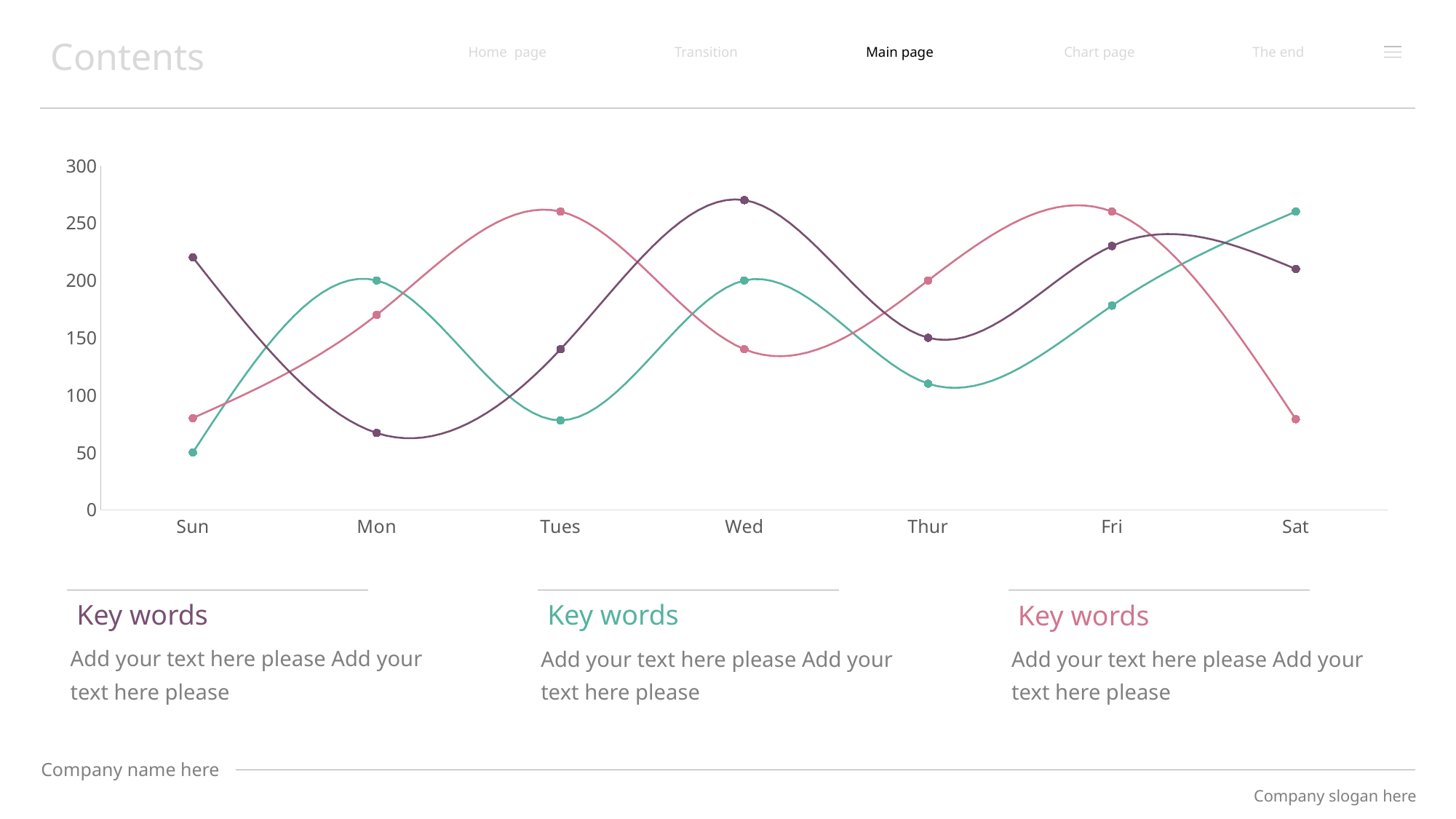
Is the value of the purple line for Mon greater or less than 100? less On Sat, which line has the larger value, the teal line or the pink line? teal line How many categories are shown on the x axis of the chart? 7 On which day does the teal line reach its highest value? Sat Is the value of the pink line for Sat greater or less than 100? less On which day does the purple line reach its highest value? Wed What kind of chart is shown on the slide? line chart How many lines are plotted on the chart? 3 On Sun, which line has the larger value, the purple line or the teal line? purple line On which day does the teal line have its lowest value? Sun Is the value of the purple line for Wed greater or less than 250? greater